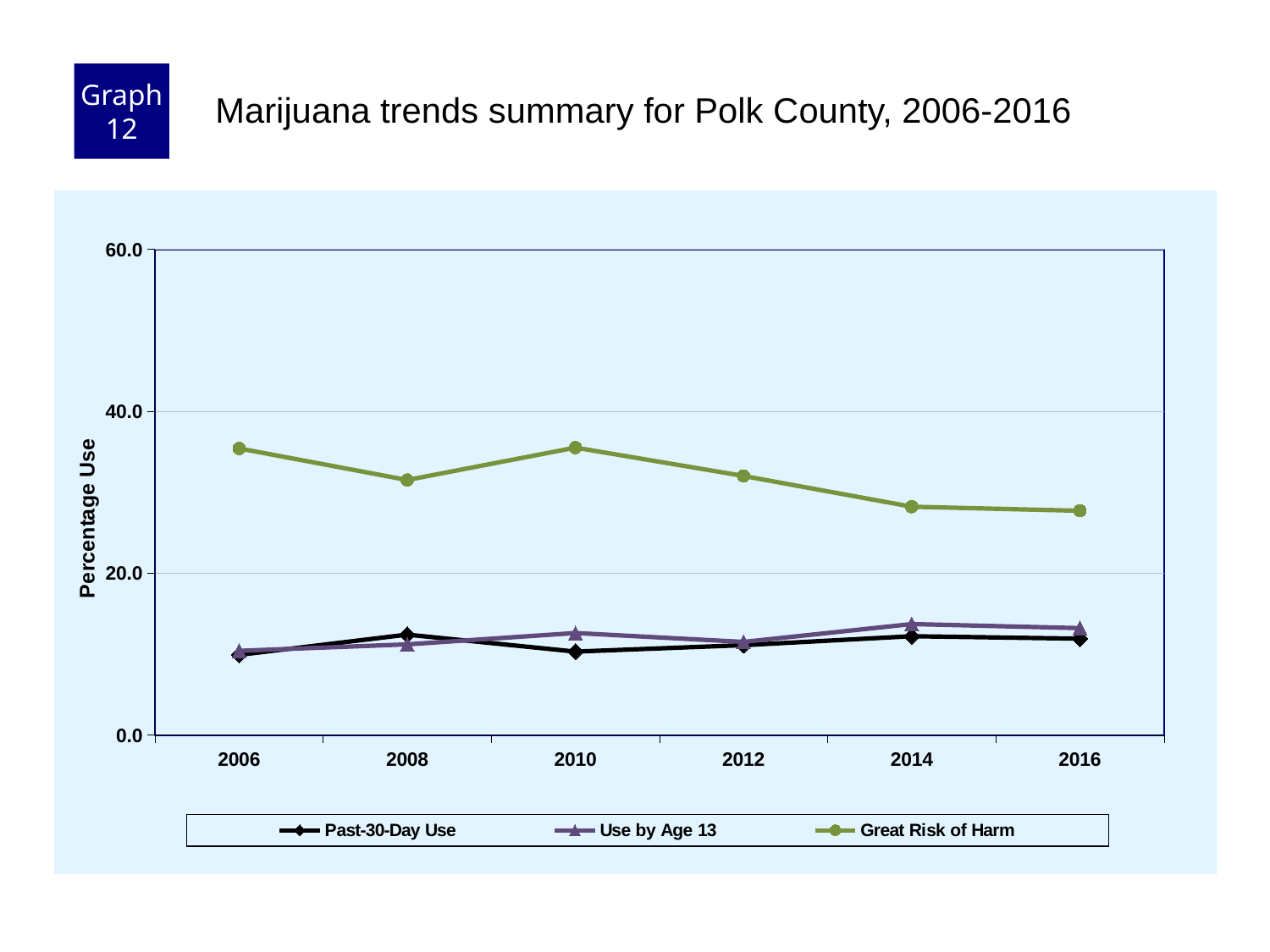
Does the Great Risk of Harm line rise or fall from 2012 to 2016? Fall For Use by Age 13, which year has the higher value: 2006 or 2014? 2014 Which series has the highest values across all years shown? Great Risk of Harm In 2012, which series has the higher value: Great Risk of Harm or Past-30-Day Use? Great Risk of Harm Is the value for Great Risk of Harm in 2010 greater or less than 40.0? less What kind of chart is shown on the slide? Line chart What is the title of the chart? Marijuana trends summary for Polk County, 2006-2016 How many years are plotted along the x axis? 6 How many series does the legend list? 3 Is the value for Great Risk of Harm in 2006 greater or less than 20.0? greater Is the value for Past-30-Day Use in 2016 greater or less than 20.0? less What is the label on the y axis? Percentage Use